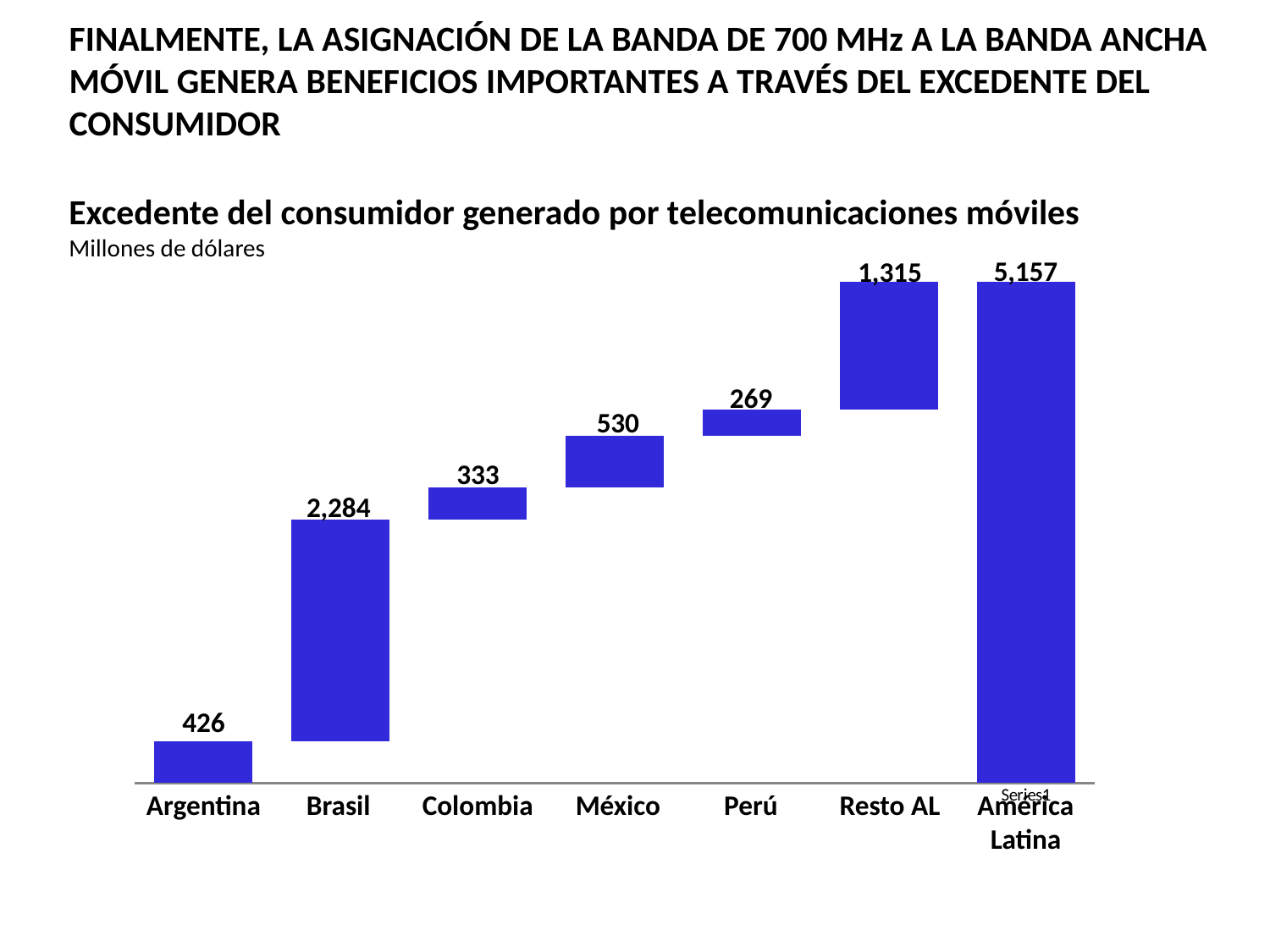
Which category has the lowest value? Perú Which is larger, the value for México or the value for Colombia? México What is the value for Colombia? 333 What kind of chart is shown on the slide? Bar chart What is the value for Resto AL? 1,315 What is the difference between the values for Brasil and Argentina? 1,858 Which individual country has the highest value? Brasil How many categories are shown on the x axis? 7 What is the value for America Latina? 5,157 What unit is stated below the chart title? Millones de dólares What is the value for Perú? 269 What is the value for Brasil? 2,284